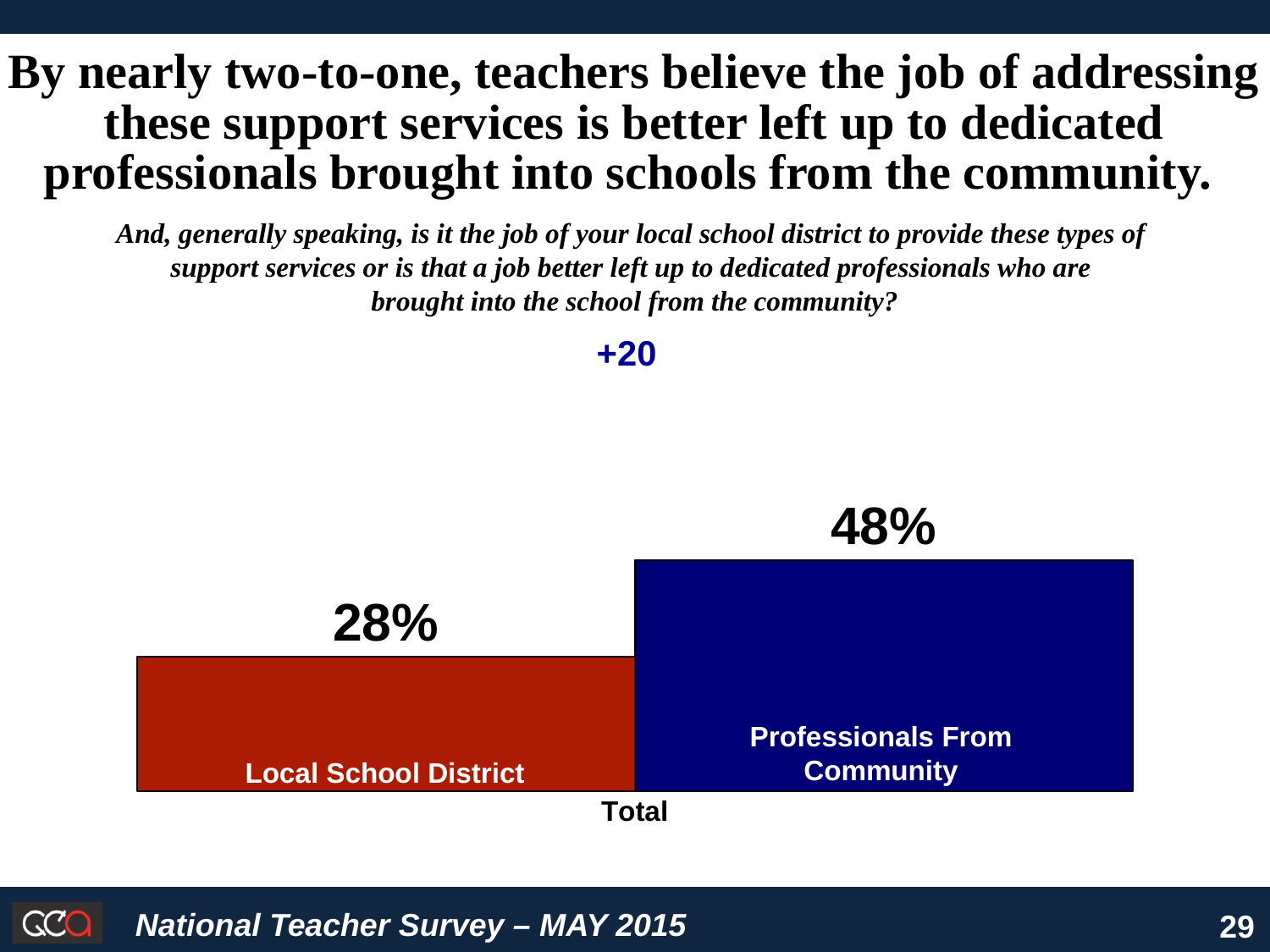
What is the difference in percentage points between Professionals From Community and Local School District? 20 What percentage of teachers say it is the job of the Local School District? 28% What is the category label shown beneath the bars? Total How many bars are shown in the chart? 2 Which response has the lowest percentage? Local School District What kind of chart is shown on the slide? bar chart What percentage of teachers say the job is better left to Professionals From Community? 48% Which response has the higher percentage, Local School District or Professionals From Community? Professionals From Community What colour is the bar for Local School District? red What net figure is printed above the chart? +20